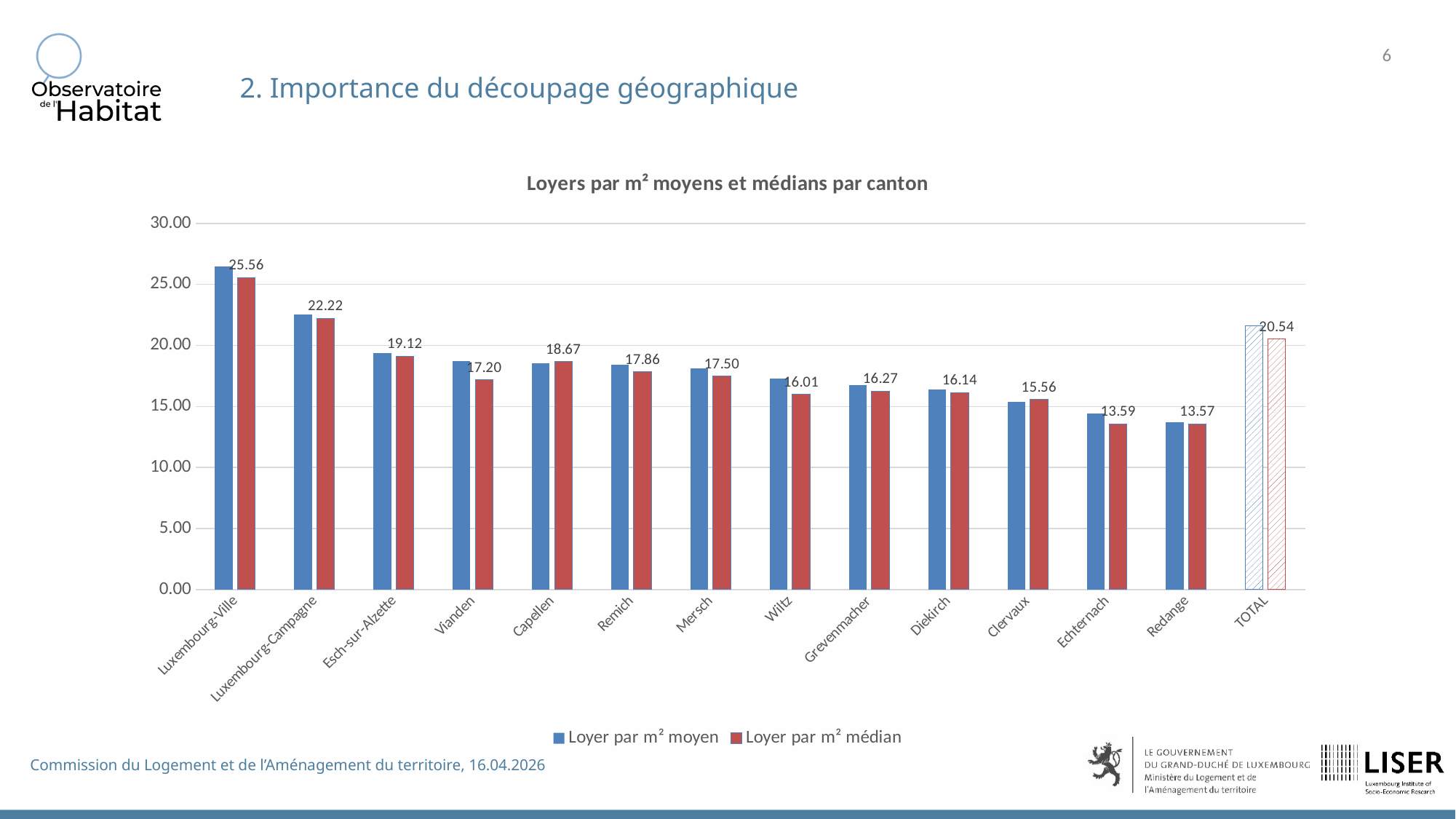
Is the Loyer par m² moyen for Echternach greater or less than 15.00? less What is the value of Loyer par m² médian for Vianden? 17.20 How many categories are shown on the x axis, including TOTAL? 14 Is the Loyer par m² moyen for Luxembourg-Ville greater or less than 25.00? greater What is the difference between the Loyer par m² médian for Luxembourg-Ville and for Luxembourg-Campagne? 3.34 What kind of chart is shown on the slide? bar chart What is the value of Loyer par m² médian for Luxembourg-Ville? 25.56 How many series does the legend list? 2 What is the value of Loyer par m² médian for TOTAL? 20.54 Which canton has the lowest Loyer par m² médian? Redange Which canton has the highest Loyer par m² médian? Luxembourg-Ville Which has a larger Loyer par m² médian, Capellen or Remich? Capellen